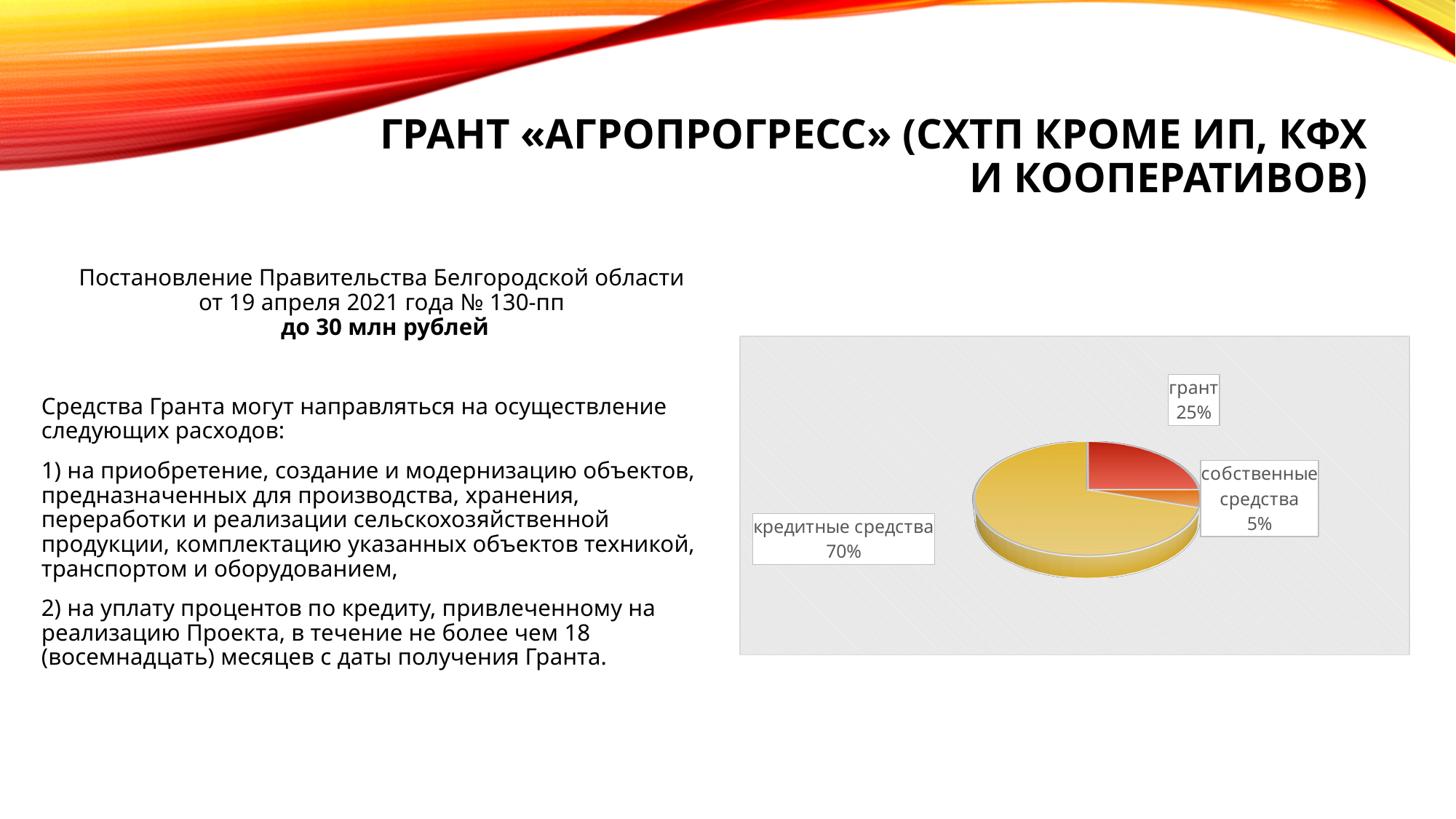
What is the difference between the shares of "грант" and "собственные средства"? 20% What share of the pie does "кредитные средства" represent? 70% What kind of chart is shown on the slide? pie chart What share of the pie does "собственные средства" represent? 5% What share of the pie does "грант" represent? 25% Which slice of the pie chart is the smallest? собственные средства How many slices does the pie chart have? 3 What is the difference between the shares of "кредитные средства" and "грант"? 45% What colour is the "кредитные средства" slice of the pie chart? yellow Which slice of the pie chart is the largest? кредитные средства What colour is the "грант" slice of the pie chart? red Which is larger, the share of "грант" or the share of "собственные средства"? грант